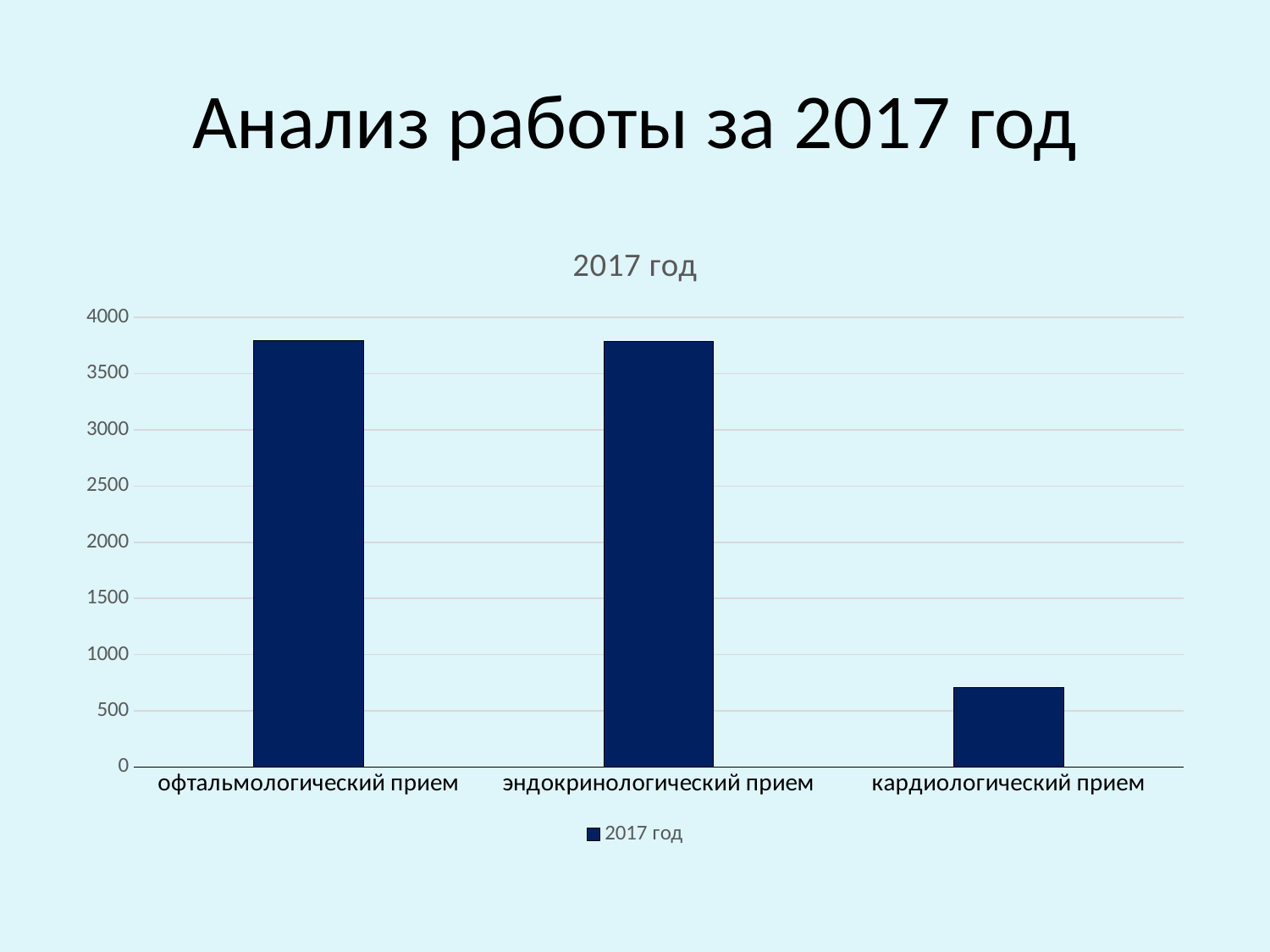
How many series does the legend list? 1 Which is larger, the value for эндокринологический прием or the value for кардиологический прием? эндокринологический прием Which category has the lowest value? кардиологический прием What is the name of the series shown in the legend? 2017 год How many categories are plotted on the chart? 3 Is the value for кардиологический прием greater or less than 1000? less Is the value for кардиологический прием greater or less than 500? greater Is the value for офтальмологический прием greater or less than 3500? greater Which is larger, the value for офтальмологический прием or the value for кардиологический прием? офтальмологический прием What is the title of the chart? 2017 год What kind of chart is shown on the slide? bar chart